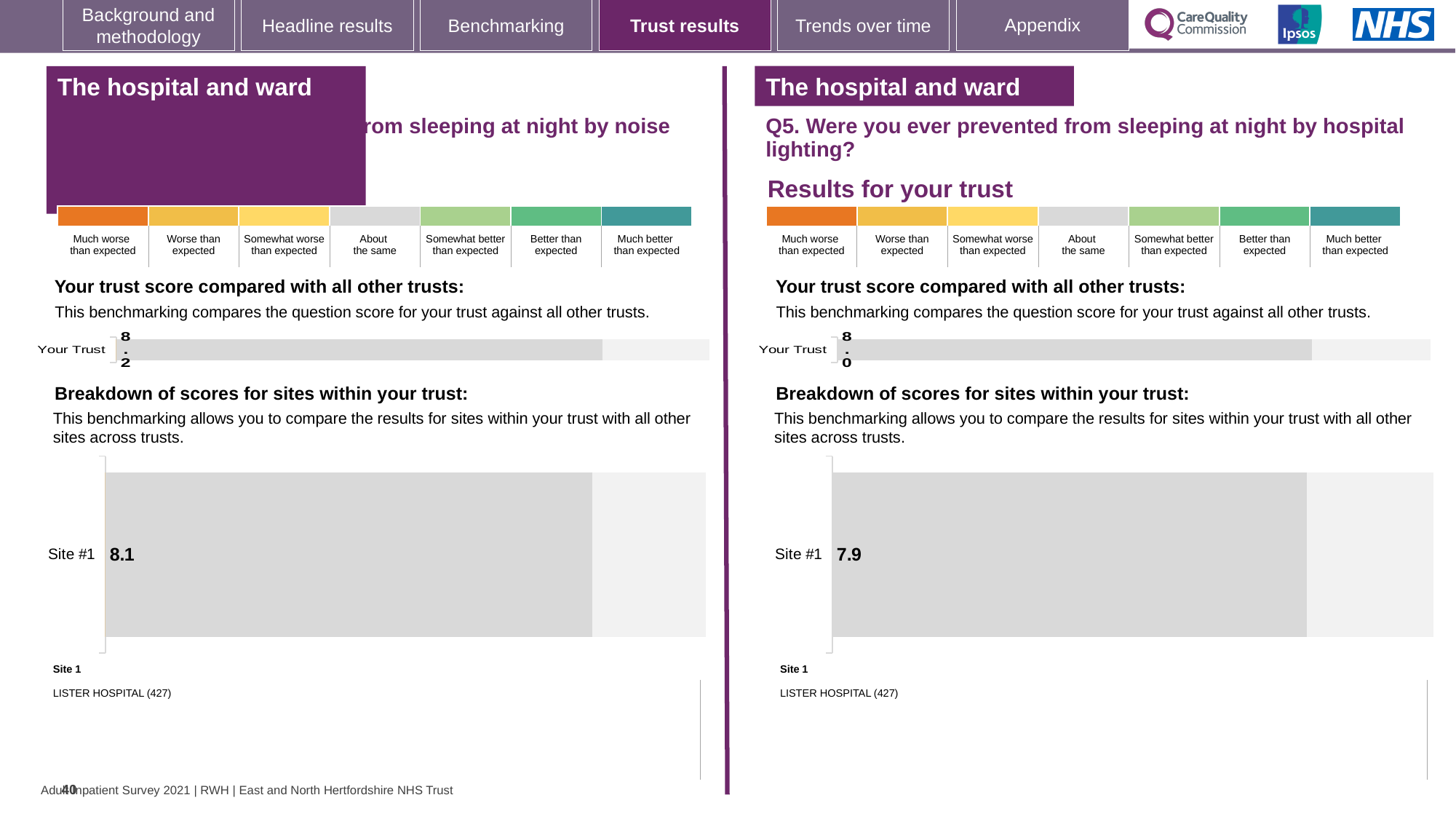
Which hospital is listed as Site 1 on the right half of the slide? LISTER HOSPITAL (427) Which is larger: the Your Trust score on the left half of the slide or the Your Trust score on the right half (Q5, hospital lighting)? Left half (8.2) On the right half of the slide (Q5, hospital lighting), what is the difference between the Your Trust score and the Site #1 score? 0.1 What kind of chart is used to show the Site #1 score on the right half of the slide? Bar chart On the right half of the slide (Q5, hospital lighting), what score is shown for Site #1 in the breakdown of scores for sites chart? 7.9 On the right half of the slide (Q5, hospital lighting), what is the score shown for Your Trust in the trust score chart? 8.0 On the left half of the slide, what score is shown for Site #1 in the breakdown of scores for sites chart? 8.1 How many categories does the colour key above the trust score chart on the right half of the slide show? 7 What is the difference between the Site #1 score on the left half of the slide and the Site #1 score on the right half (Q5, hospital lighting)? 0.2 How many sites are shown in the breakdown of scores for sites chart on the left half of the slide? 1 On the left half of the slide, what is the score shown for Your Trust in the trust score chart? 8.2 On the left half of the slide, what is the difference between the Your Trust score and the Site #1 score? 0.1